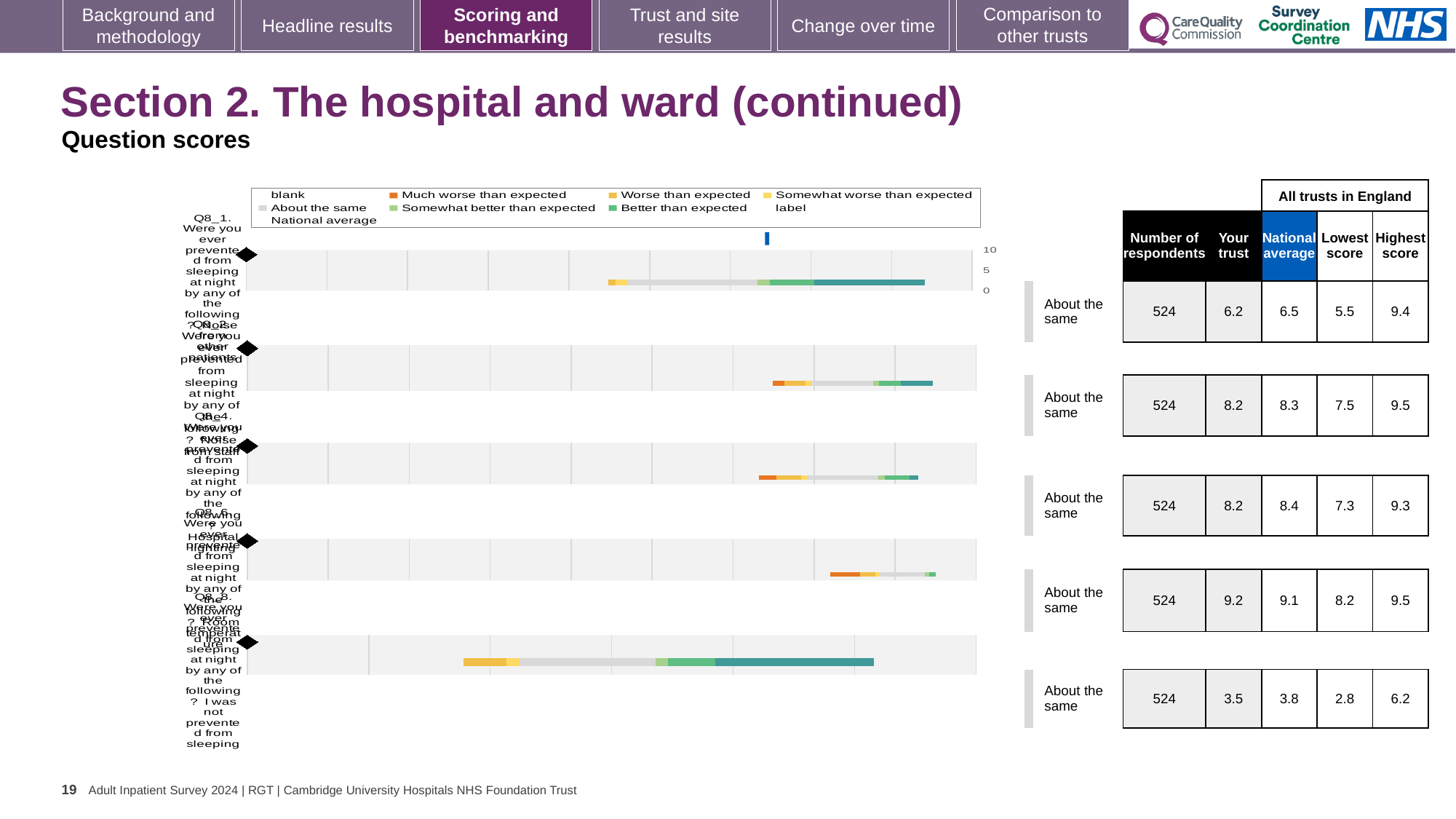
Which row has the lowest 'Your trust' score? Q8_8 (fifth row) Which row has the highest 'Your trust' score? Q8_6 (fourth row) For the fourth row (Q8_6), which is larger: the 'Your trust' score or the national average? Your trust How many respondents are listed for each row? 524 What is the highest score across all trusts in England for the second row (Q8_2)? 9.5 What is the 'Your trust' score for the first row (Q8_1)? 6.2 For the first row (Q8_1), what is the difference between the national average and the 'Your trust' score? 0.3 In the chart legend, which entry is shown with the dark orange colour? Much worse than expected What kind of chart is shown on the slide? bar chart How many question rows (bars) are plotted in the chart? 5 What is the national average for the last row (Q8_8)? 3.8 What benchmark category is written beside every bar in the chart? About the same